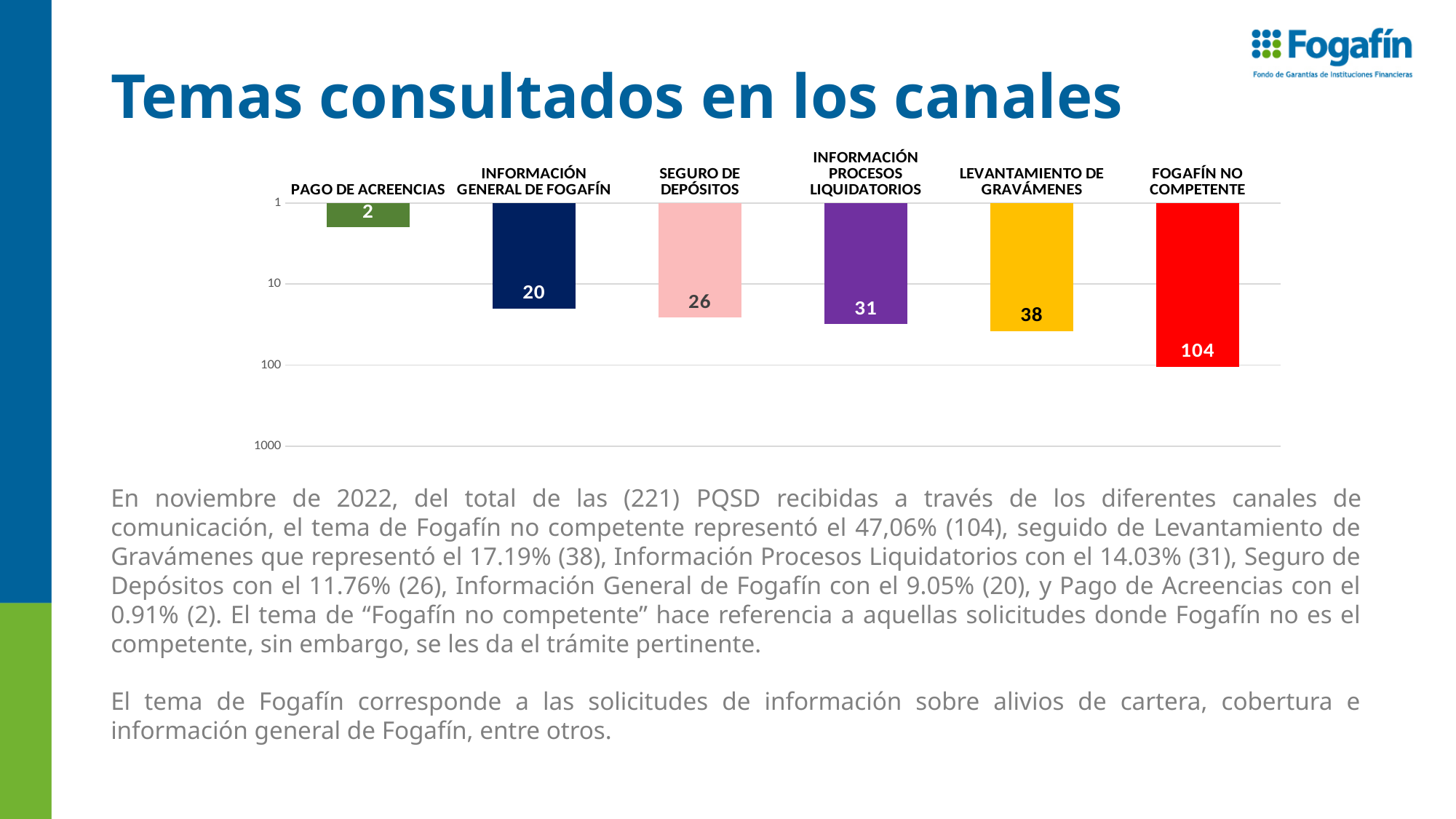
What is the difference between the values for FOGAFÍN NO COMPETENTE and LEVANTAMIENTO DE GRAVÁMENES? 66 What colour is the bar for FOGAFÍN NO COMPETENTE? red Which category has the lowest value? PAGO DE ACREENCIAS What kind of chart is shown on the slide? bar chart What is the value for FOGAFÍN NO COMPETENTE? 104 What is the value for PAGO DE ACREENCIAS? 2 What is the value for LEVANTAMIENTO DE GRAVÁMENES? 38 How many categories are shown in the chart? 6 Is the value for FOGAFÍN NO COMPETENTE greater or less than 100? greater Which is larger, the value for INFORMACIÓN PROCESOS LIQUIDATORIOS or the value for INFORMACIÓN GENERAL DE FOGAFÍN? INFORMACIÓN PROCESOS LIQUIDATORIOS What is the value for SEGURO DE DEPÓSITOS? 26 Which category has the highest value? FOGAFÍN NO COMPETENTE